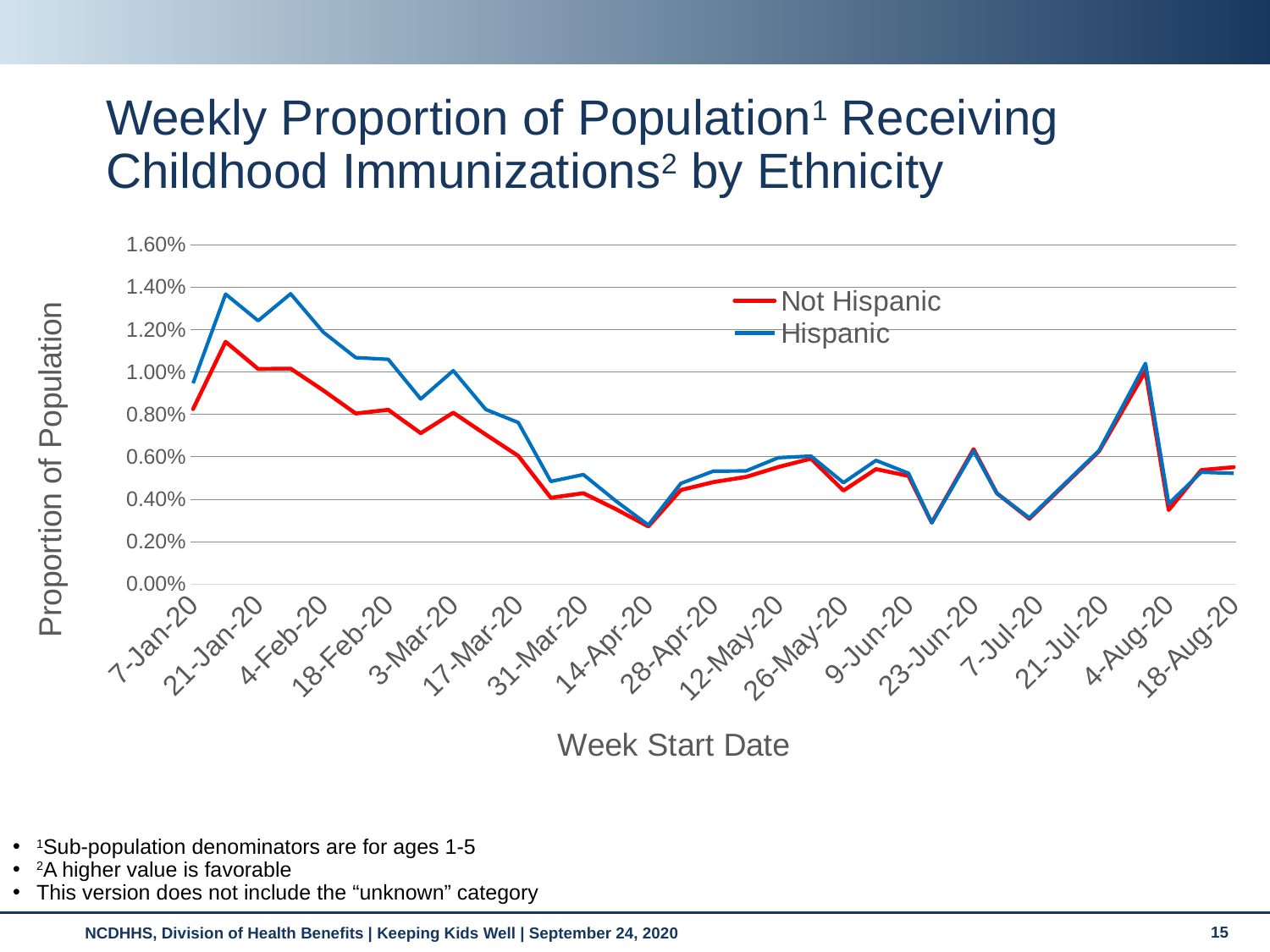
Does the Not Hispanic series generally rise or fall from 21-Jan-20 to 14-Apr-20? Fall At 3-Mar-20, which series has the higher value, Hispanic or Not Hispanic? Hispanic Is the Not Hispanic value for 14-Apr-20 greater or less than 0.40%? less At 21-Jan-20, which series has the higher value, Hispanic or Not Hispanic? Hispanic Is the Hispanic value for 18-Aug-20 greater or less than 0.60%? less Is the Hispanic value for 21-Jan-20 greater or less than 1.20%? greater What kind of chart is shown on the slide? Line chart What is the title of the vertical axis? Proportion of Population How many series does the legend list? 2 Which series is drawn in red? Not Hispanic